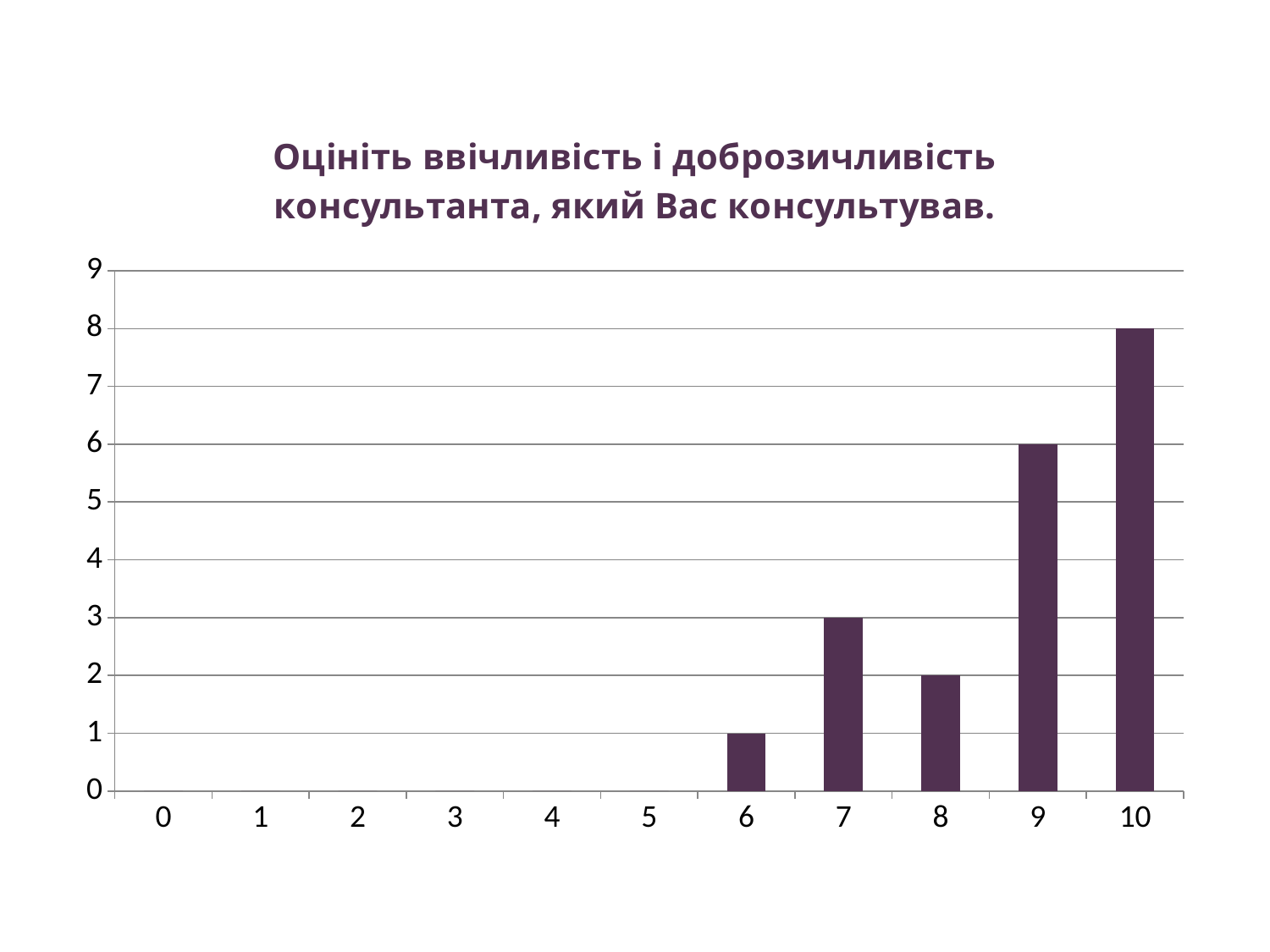
What is the difference between the values for category 10 and category 9? 2 Which is larger, the value for category 7 or the value for category 8? 7 What is the title of the chart? Оцініть ввічливість і доброзичливість консультанта, який Вас консультував. What type of chart is shown on the slide? bar chart What is the value for category 9? 6 How many categories are shown on the x axis? 11 Is the value for category 9 greater or less than 5? greater What is the value for category 6? 1 Which category has the highest value? 10 What is the value for category 10? 8 Do the values generally rise or fall from category 6 to category 10? rise What is the value for category 7? 3